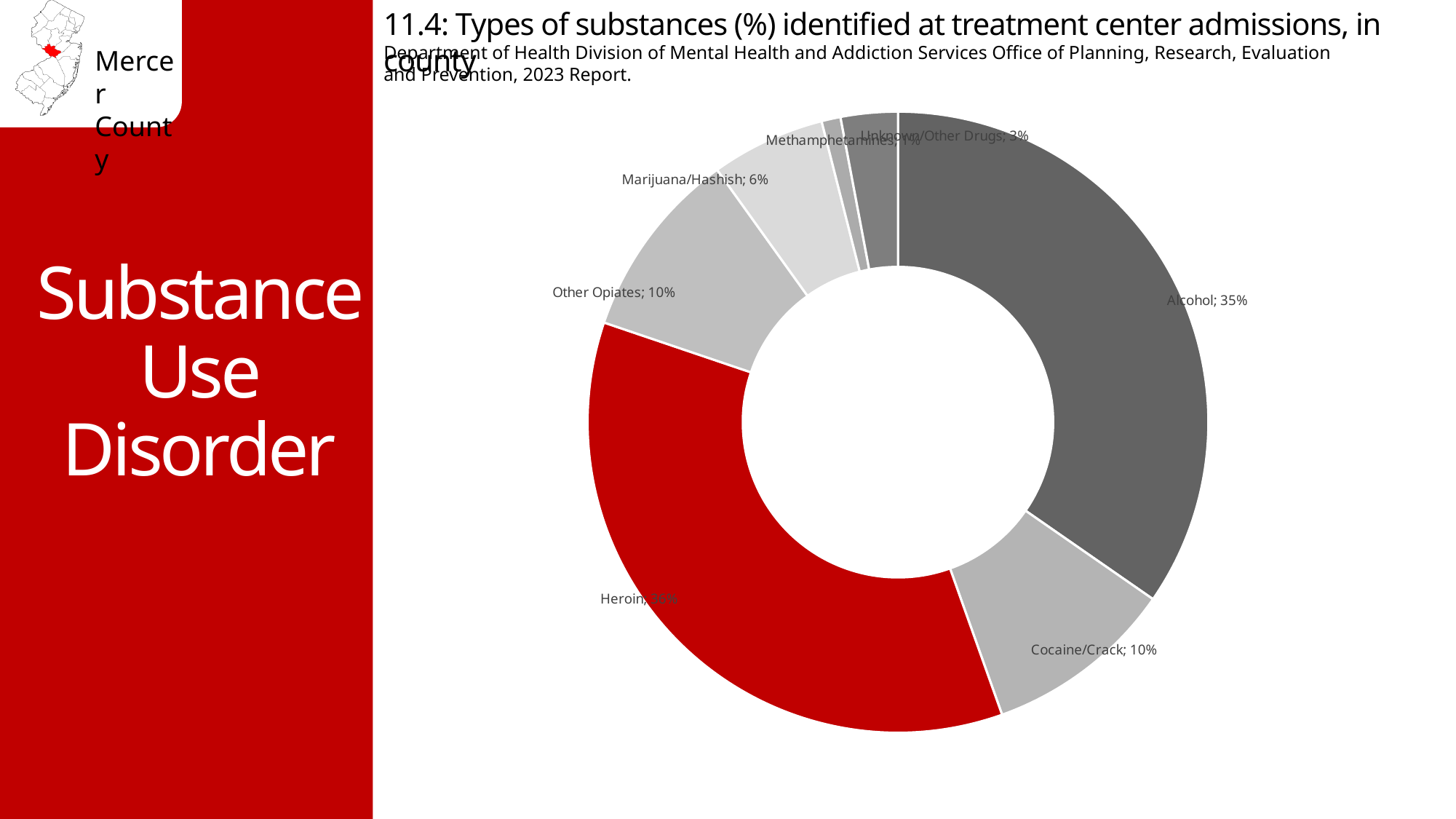
Which is larger, the share for Alcohol or the share for Other Opiates? Alcohol Which substance has the smallest share of admissions? Methamphetamines How many substance categories are shown in the chart? 7 What percentage is shown for Cocaine/Crack? 10% What kind of chart is shown on the slide? Doughnut (pie) chart What percentage of treatment center admissions identified Alcohol? 35% What percentage is shown for Other Opiates? 10% What percentage is shown for Unknown/Other Drugs? 3% Which slice of the chart is coloured red? Heroin What percentage is shown for Heroin? 36% What percentage is shown for Marijuana/Hashish? 6% What is the difference between the Alcohol share and the Cocaine/Crack share? 25%